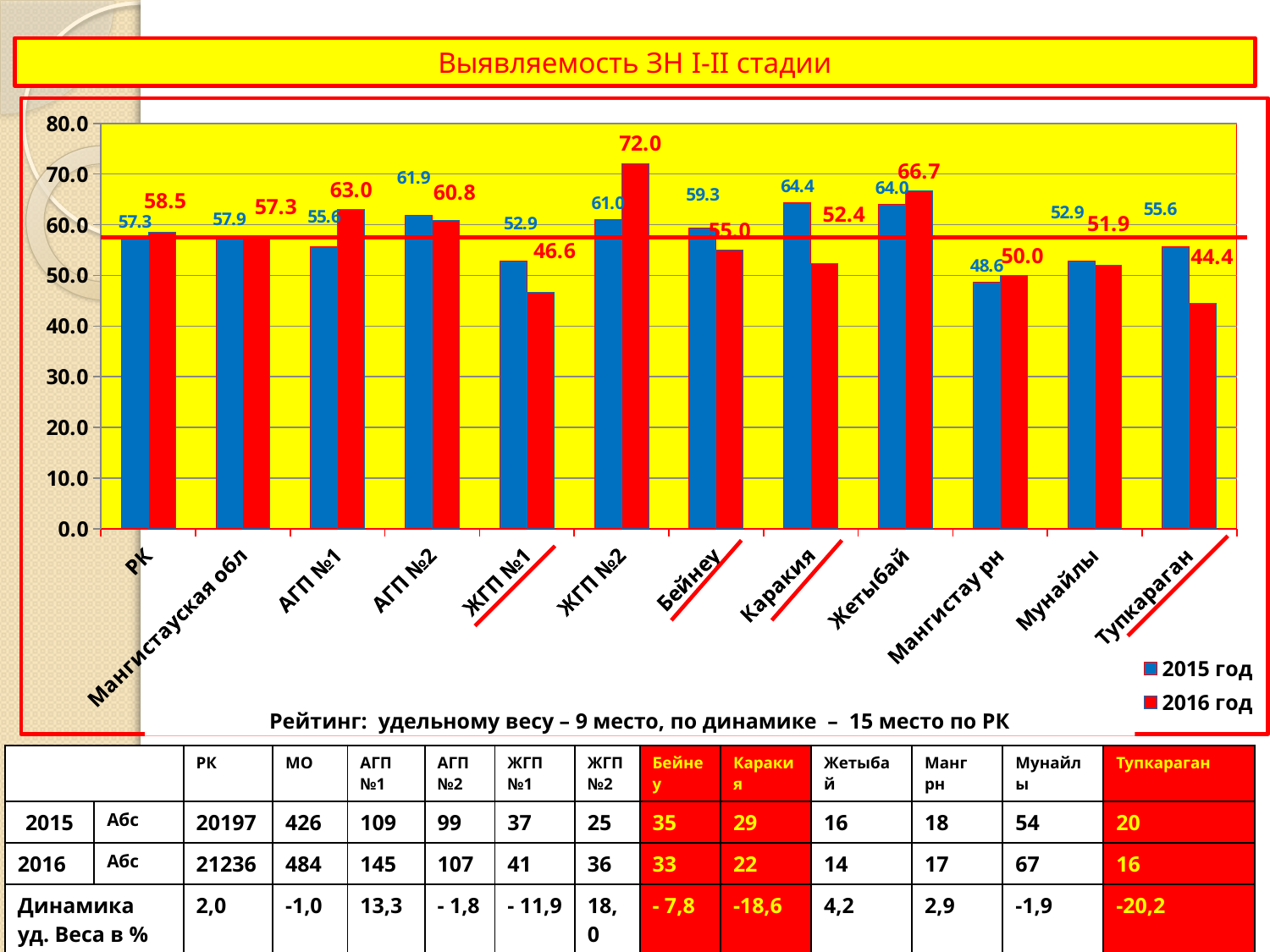
Which is larger for Каракия: the 2015 год value or the 2016 год value? 2015 год Is the 2016 год value for Тупкараган greater or less than 50.0? less What is the title of the chart? Выявляемость ЗН I-II стадии Which category has the lowest 2016 год value? Тупкараган What is the difference between the 2016 год and 2015 год values for ЖГП №2? 11.0 Which category has the lowest 2015 год value? Мангистау рн What is the 2015 год value for Каракия? 64.4 How many categories are shown along the x axis of the chart? 12 What is the 2016 год value for ЖГП №2? 72.0 Which category has the highest 2016 год value? ЖГП №2 How many series does the chart legend list? 2 What type of chart is shown on the slide? bar chart